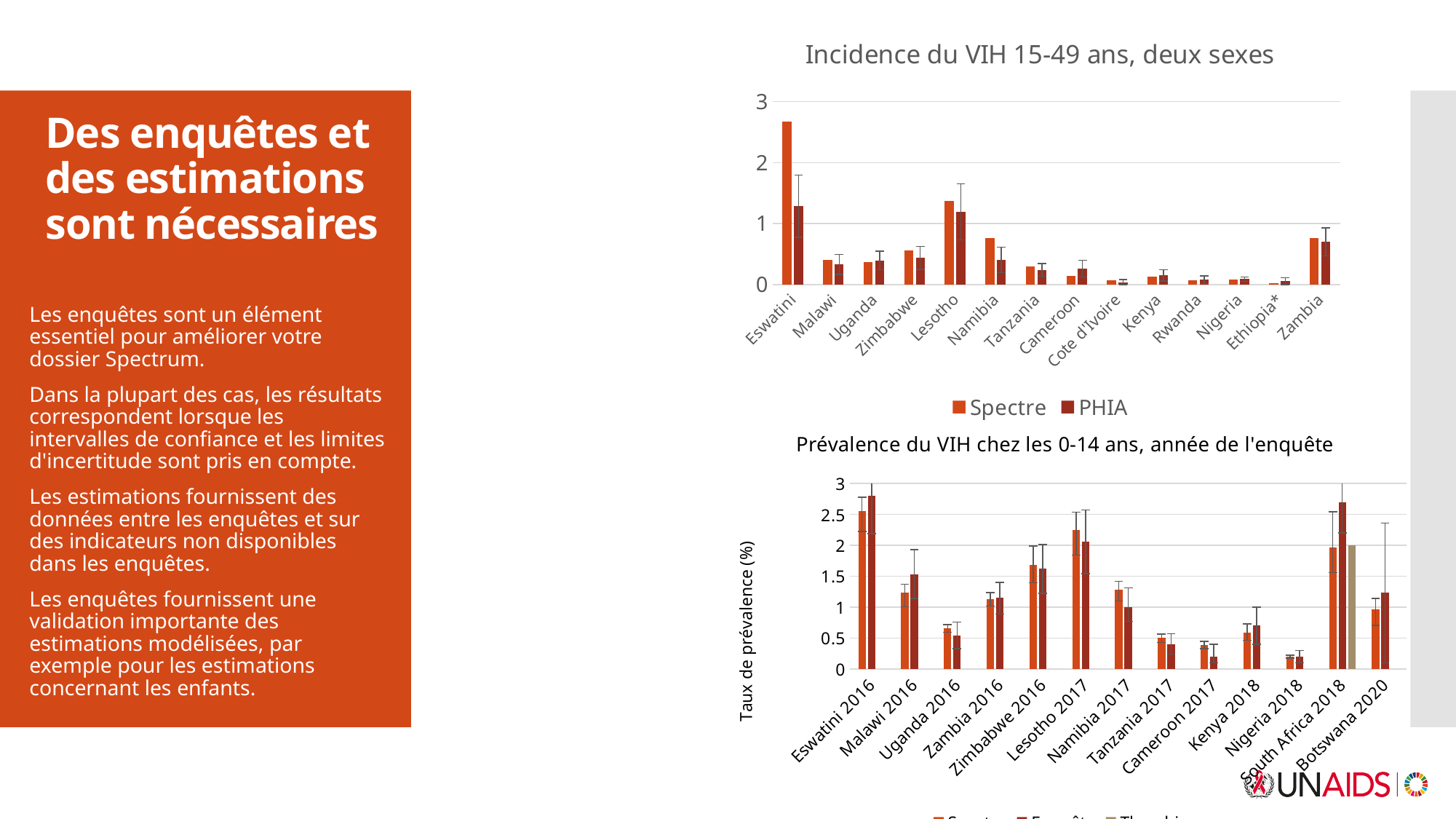
What is the y-axis label of the 'Prévalence du VIH chez les 0-14 ans, année de l'enquête' chart? Taux de prévalence (%) In the 'Prévalence du VIH chez les 0-14 ans, année de l'enquête' chart, is the Spectre value for Eswatini 2016 greater or less than 2? greater How many categories are shown on the x axis of the 'Prévalence du VIH chez les 0-14 ans, année de l'enquête' chart? 13 In the 'Prévalence du VIH chez les 0-14 ans, année de l'enquête' chart, which is larger: the Spectre value for Nigeria 2018 or the Spectre value for Malawi 2016? Malawi 2016 In the 'Incidence du VIH 15-49 ans, deux sexes' chart, which country has the highest Spectre value? Eswatini In the 'Incidence du VIH 15-49 ans, deux sexes' chart, is the Spectre value for Lesotho greater or less than 1? greater What kind of chart is the 'Incidence du VIH 15-49 ans, deux sexes' chart? bar chart In the 'Incidence du VIH 15-49 ans, deux sexes' chart, is the Spectre value for Eswatini greater or less than 2? greater In the 'Incidence du VIH 15-49 ans, deux sexes' chart, which is larger for Eswatini: the Spectre value or the PHIA value? Spectre How many series does the legend of the 'Incidence du VIH 15-49 ans, deux sexes' chart list? 2 How many countries are shown on the x axis of the 'Incidence du VIH 15-49 ans, deux sexes' chart? 14 What are the two legend entries of the 'Incidence du VIH 15-49 ans, deux sexes' chart? Spectre and PHIA